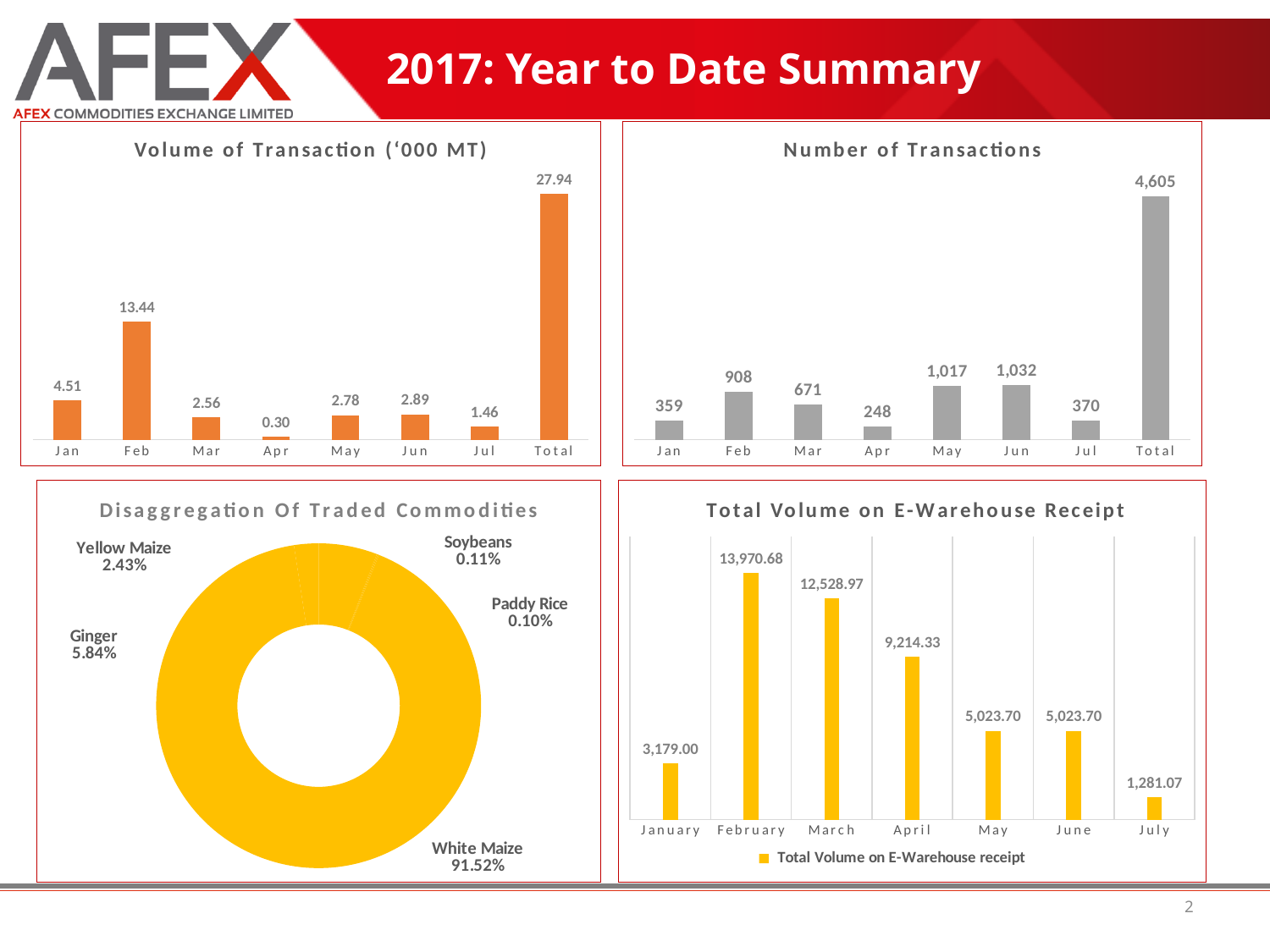
In the 'Number of Transactions' chart, what is the difference between Feb and Mar? 237 In the 'Volume of Transaction ('000 MT)' chart, what is the value for Feb? 13.44 In the 'Disaggregation Of Traded Commodities' chart, how many commodities are shown? 5 In the 'Total Volume on E-Warehouse Receipt' chart, what is the value for March? 12,528.97 In the 'Disaggregation Of Traded Commodities' chart, what share does White Maize have? 91.52% In the 'Number of Transactions' chart, what is the Total value? 4,605 In the 'Disaggregation Of Traded Commodities' chart, which is larger, Ginger or Yellow Maize? Ginger In the 'Number of Transactions' chart, which month has the lowest number of transactions? Apr In the 'Volume of Transaction ('000 MT)' chart, which month has the lowest value? Apr What type of chart is the 'Disaggregation Of Traded Commodities' chart? Doughnut chart In the 'Total Volume on E-Warehouse Receipt' chart, which month has the highest value? February In the 'Number of Transactions' chart, what is the value for May? 1,017